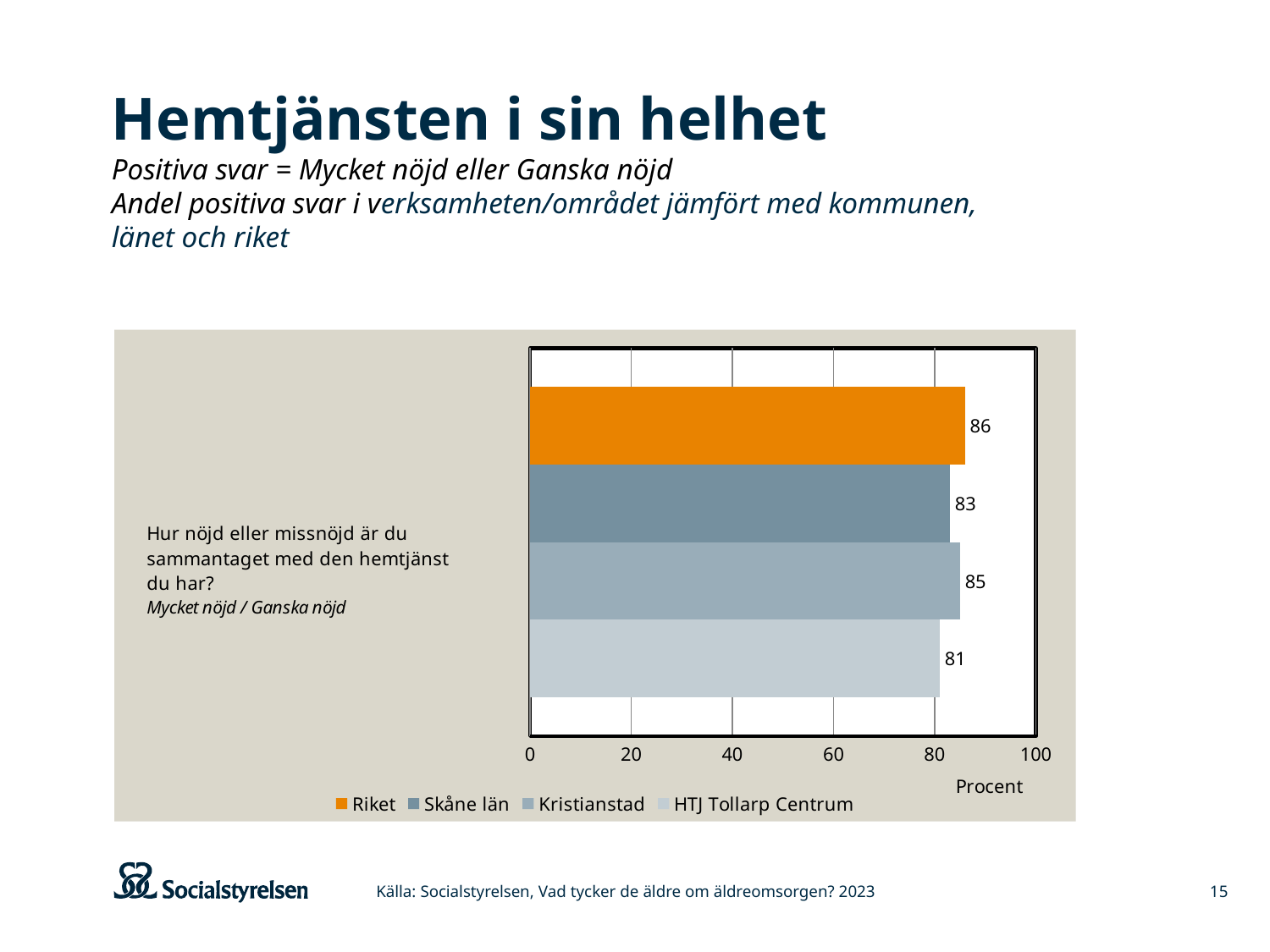
Which is larger, the value for Kristianstad or the value for HTJ Tollarp Centrum? Kristianstad What is the label of the x axis? Procent What is the value for Kristianstad? 85 How many series does the legend list? 4 What is the difference between the values for Kristianstad and Skåne län? 2 What kind of chart is shown on the slide? Bar chart Which series has the lowest value? HTJ Tollarp Centrum What is the value for Skåne län? 83 What is the value for HTJ Tollarp Centrum? 81 What is the value for Riket? 86 What is the difference between the values for Riket and HTJ Tollarp Centrum? 5 Which series has the highest value? Riket